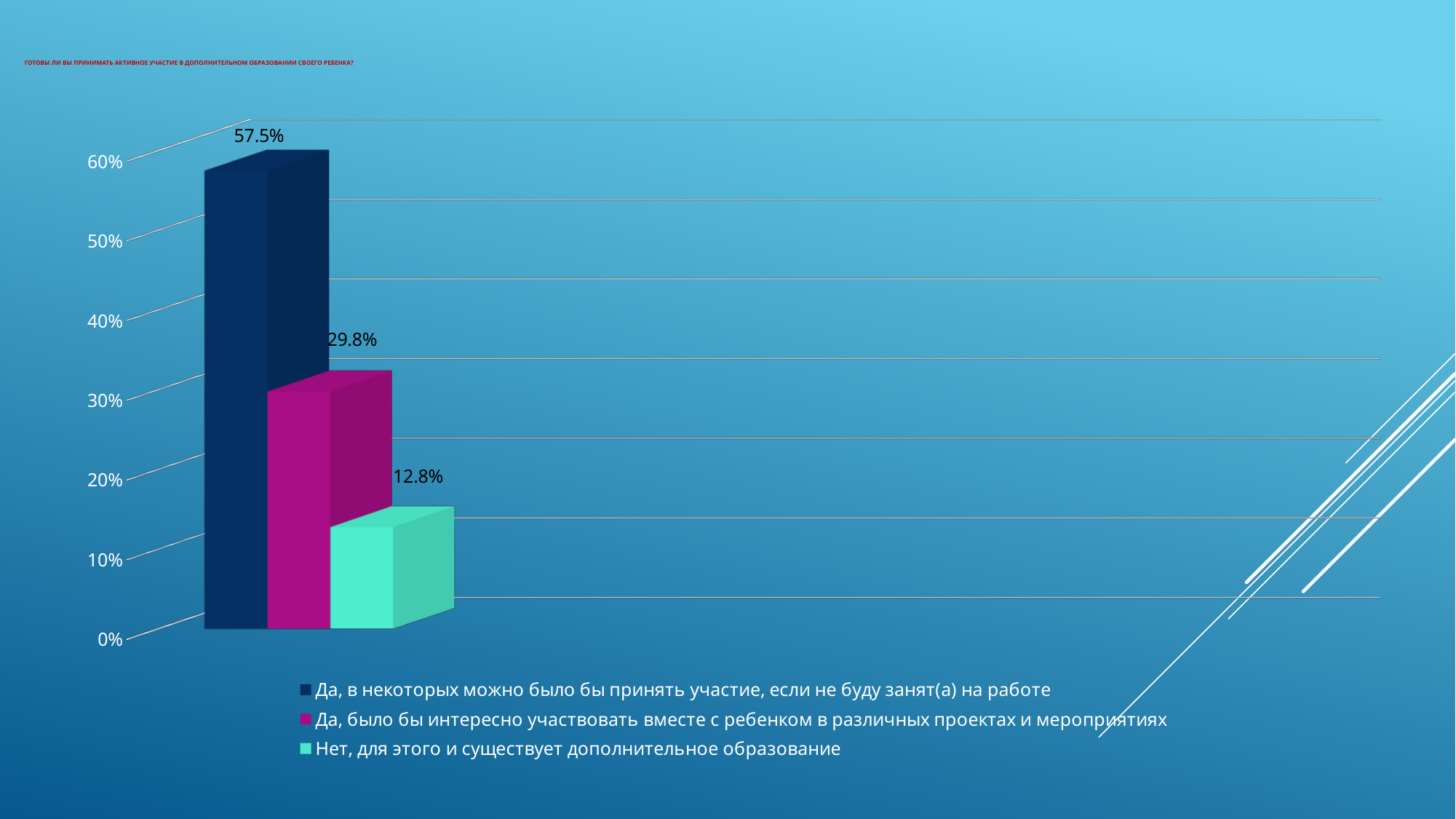
How many entries does the legend list? 3 What kind of chart is shown on the slide? bar chart What value is shown for "Да, было бы интересно участвовать вместе с ребенком в различных проектах и мероприятиях"? 29.8% What is the difference between the values for "Да, было бы интересно участвовать вместе с ребенком в различных проектах и мероприятиях" and "Нет, для этого и существует дополнительное образование"? 17.0% What value is shown for "Да, в некоторых можно было бы принять участие, если не буду занят(а) на работе"? 57.5% Which is larger: the value for "Да, было бы интересно участвовать вместе с ребенком в различных проектах и мероприятиях" or for "Нет, для этого и существует дополнительное образование"? Да, было бы интересно участвовать вместе с ребенком в различных проектах и мероприятиях Which response has the lowest value? Нет, для этого и существует дополнительное образование What value is shown for "Нет, для этого и существует дополнительное образование"? 12.8% How many bars are plotted on the chart? 3 Is the value for "Да, в некоторых можно было бы принять участие, если не буду занят(а) на работе" greater or less than 50%? greater What is the difference between the values for "Да, в некоторых можно было бы принять участие, если не буду занят(а) на работе" and "Да, было бы интересно участвовать вместе с ребенком в различных проектах и мероприятиях"? 27.7% Which response has the highest value? Да, в некоторых можно было бы принять участие, если не буду занят(а) на работе